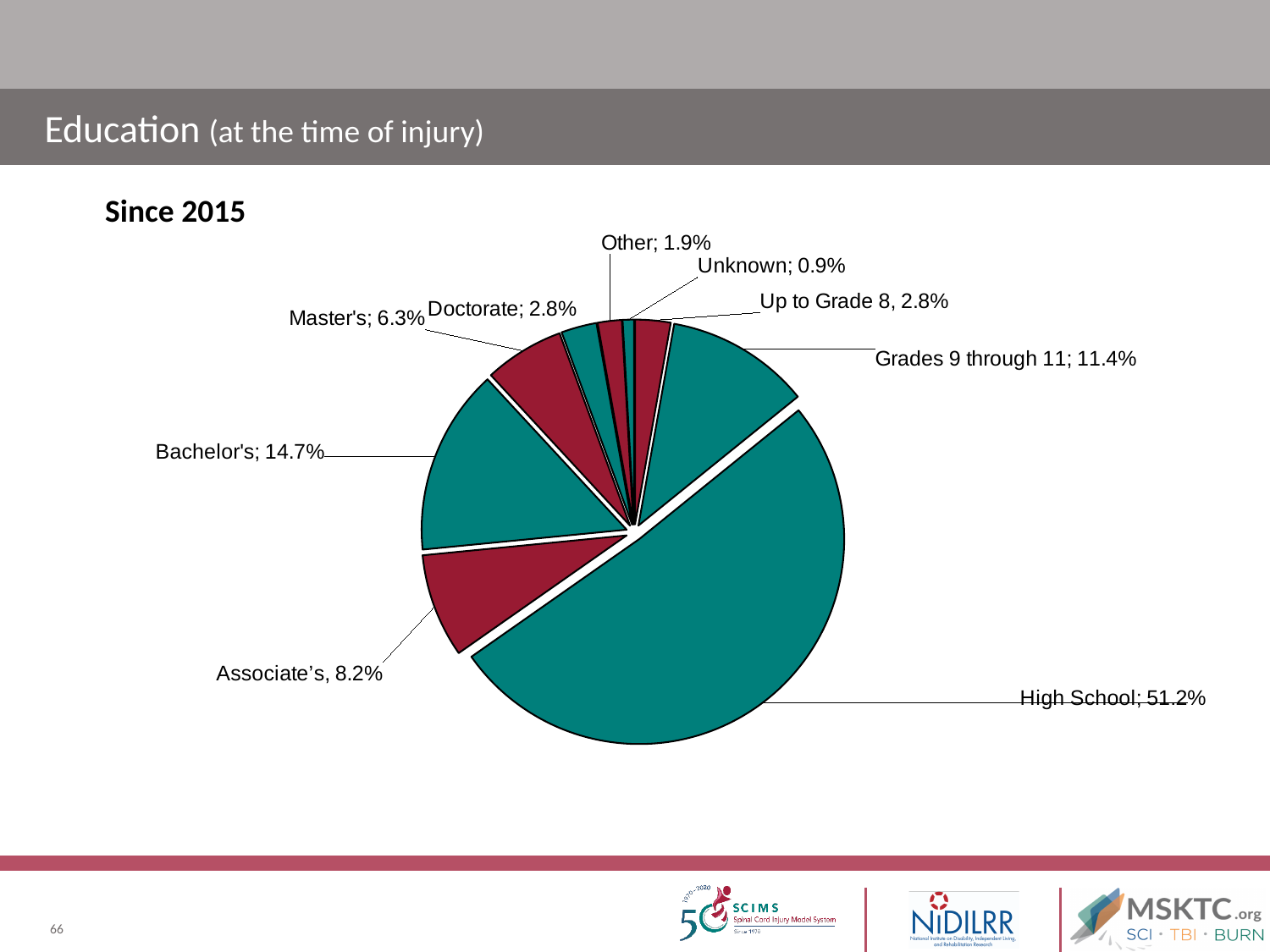
Which is larger, the share for Master's or the share for Doctorate? Master's What is the value shown for Grades 9 through 11? 11.4% What is the value shown for Bachelor's? 14.7% What type of chart is shown on the slide? Pie chart Which category has the largest slice of the pie? High School How many categories (slices) does the pie chart have? 9 What share of the pie is labelled High School? 51.2% What is the combined share of Up to Grade 8 and Grades 9 through 11? 14.2% Which category has the smallest slice of the pie? Unknown What is the value shown for Unknown? 0.9% What is the heading shown above the pie chart? Since 2015 What is the difference between the Bachelor's share and the Associate's share? 6.5%